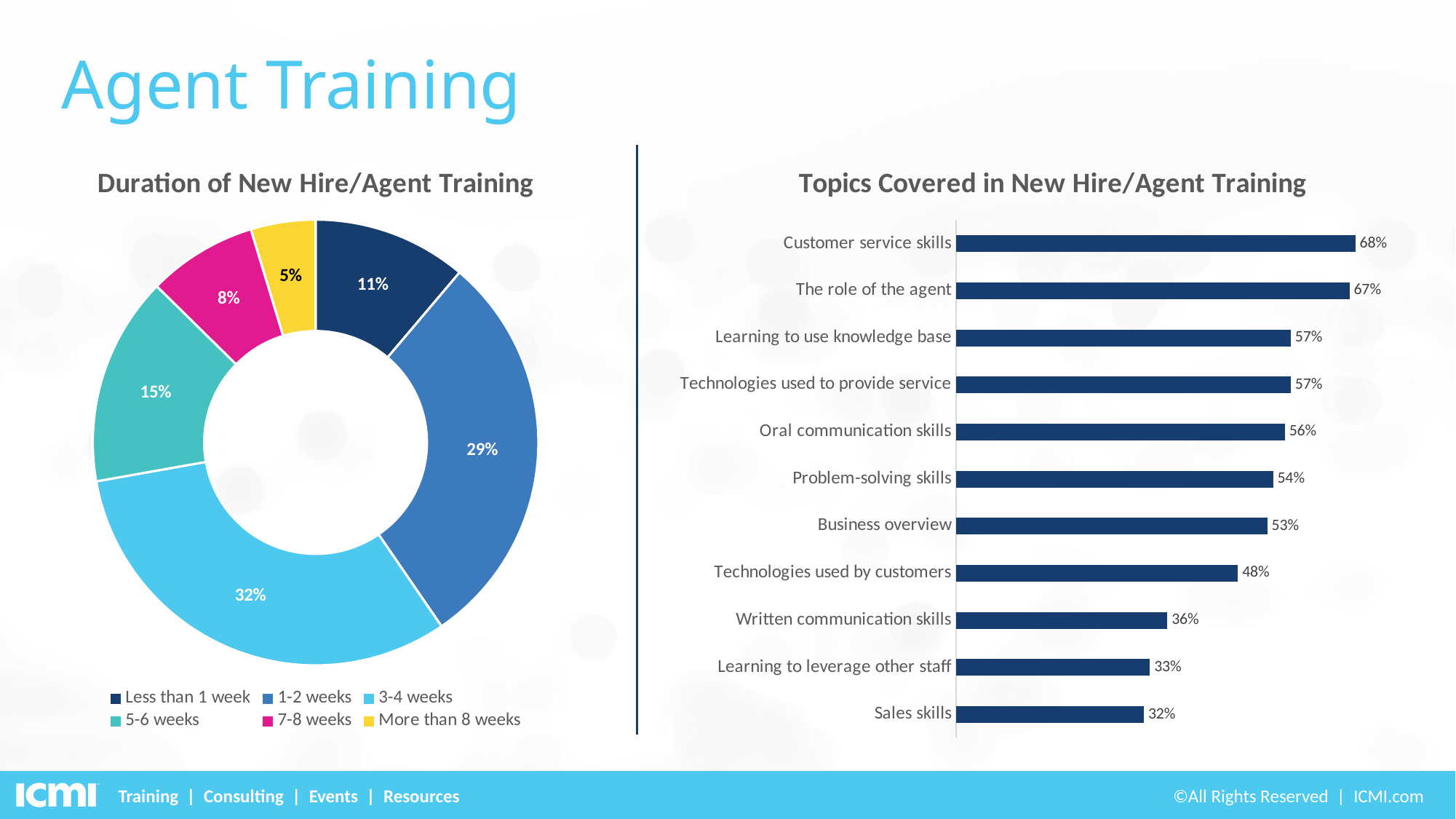
In the 'Duration of New Hire/Agent Training' chart, what is the difference between the shares for 5-6 weeks and 7-8 weeks? 7% In the 'Topics Covered in New Hire/Agent Training' chart, what is the difference between Customer service skills and Written communication skills? 32% In the 'Duration of New Hire/Agent Training' chart, what share of respondents reported 1-2 weeks? 29% What kind of chart is 'Topics Covered in New Hire/Agent Training'? Bar chart In the 'Topics Covered in New Hire/Agent Training' chart, how many topics are shown? 11 In the 'Duration of New Hire/Agent Training' chart, what share of respondents reported 3-4 weeks? 32% In the 'Duration of New Hire/Agent Training' chart, how many duration categories does the legend list? 6 In the 'Duration of New Hire/Agent Training' chart, which duration category has the smallest share? More than 8 weeks In the 'Topics Covered in New Hire/Agent Training' chart, which topic has the lowest value? Sales skills In the 'Duration of New Hire/Agent Training' chart, which duration category has the largest share? 3-4 weeks In the 'Topics Covered in New Hire/Agent Training' chart, what is the value for Problem-solving skills? 54% In the 'Topics Covered in New Hire/Agent Training' chart, which topic has the highest value? Customer service skills